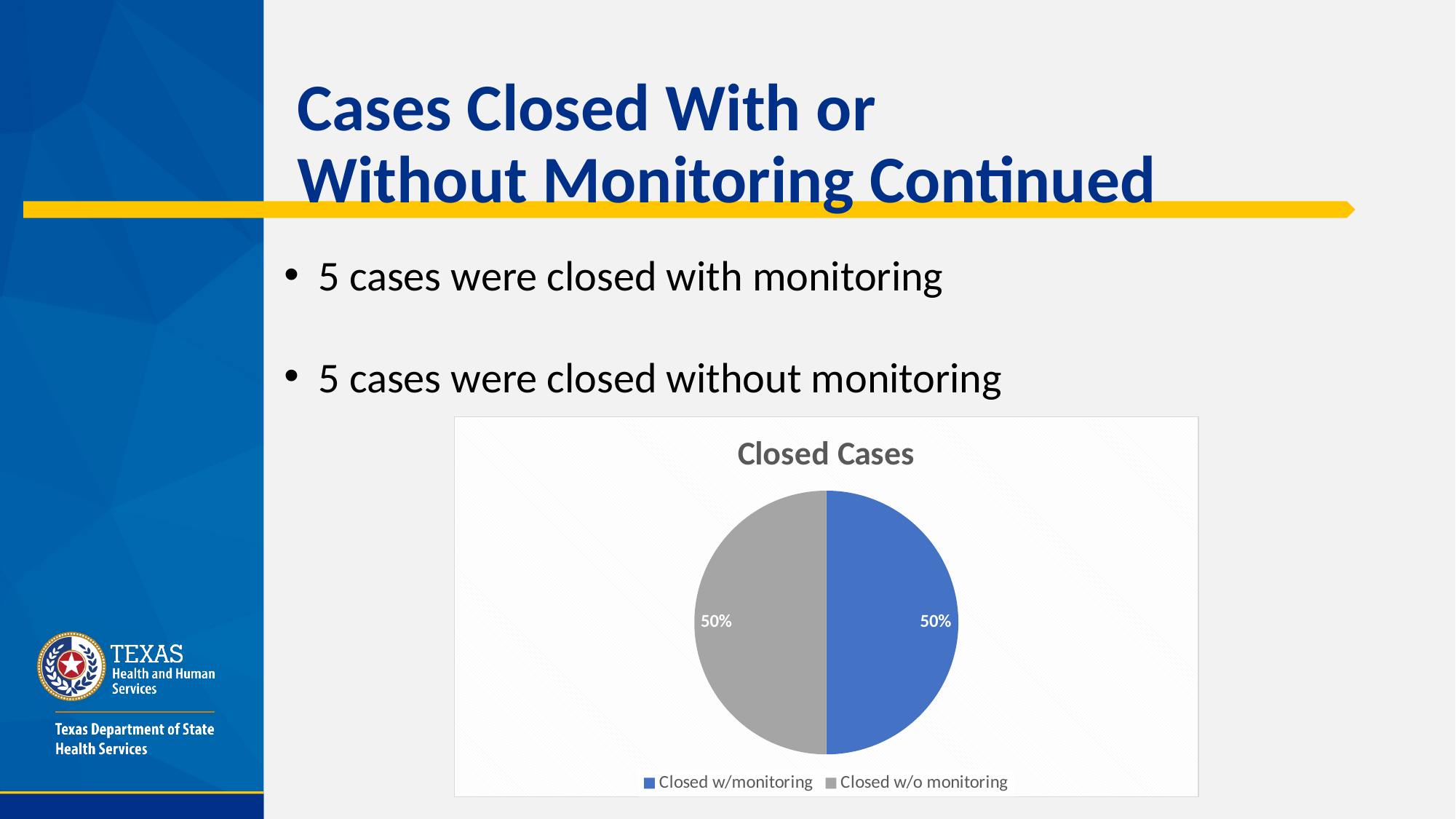
How many entries does the chart legend list? 2 What is the total of the two percentages shown on the pie chart? 100% What share of the pie is labelled for Closed w/monitoring? 50% What share of the pie is labelled for Closed w/o monitoring? 50% What is the title of the chart? Closed Cases What kind of chart is shown on the slide? pie chart Which colour represents Closed w/o monitoring in the pie chart? gray How many slices does the pie chart have? 2 What is the difference between the percentage for Closed w/monitoring and the percentage for Closed w/o monitoring? 0%